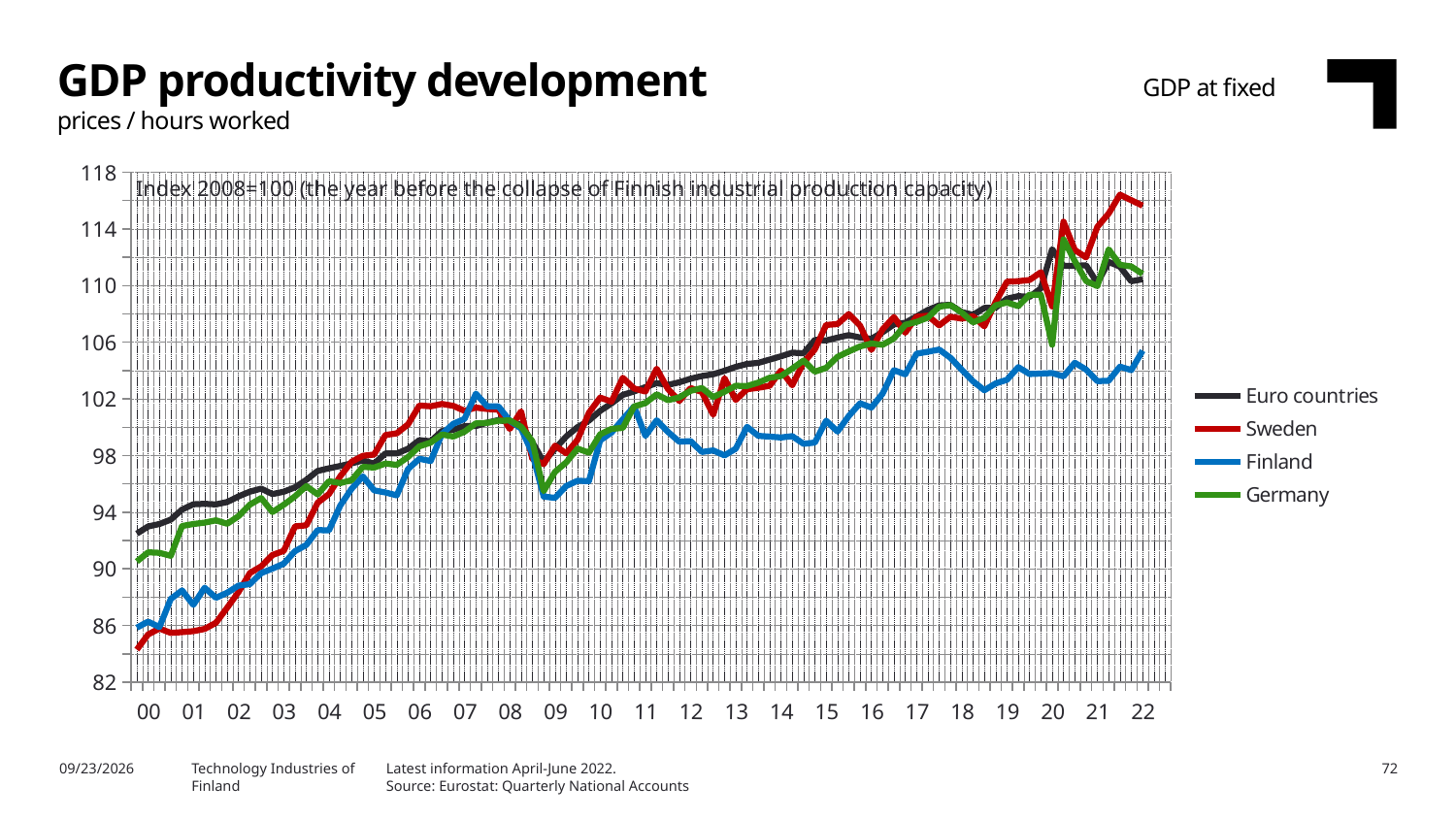
At 00, which is larger: the value for Euro countries or the value for Finland? Euro countries Is the value for Finland at 00 greater or less than 90? less Which series has the lowest value at the end of the chart (22)? Finland What kind of chart is shown on the slide? line chart Overall, does the Finland series rise or fall from 00 to 22? rise Is the value for Finland at 22 greater or less than 110? less Which series has the highest value at the end of the chart (22)? Sweden How many series does the legend list? 4 Is the value for Sweden at 22 greater or less than 114? greater Which series are listed in the legend? Euro countries, Sweden, Finland, Germany Which year is used as the index base (=100) in the chart? 2008